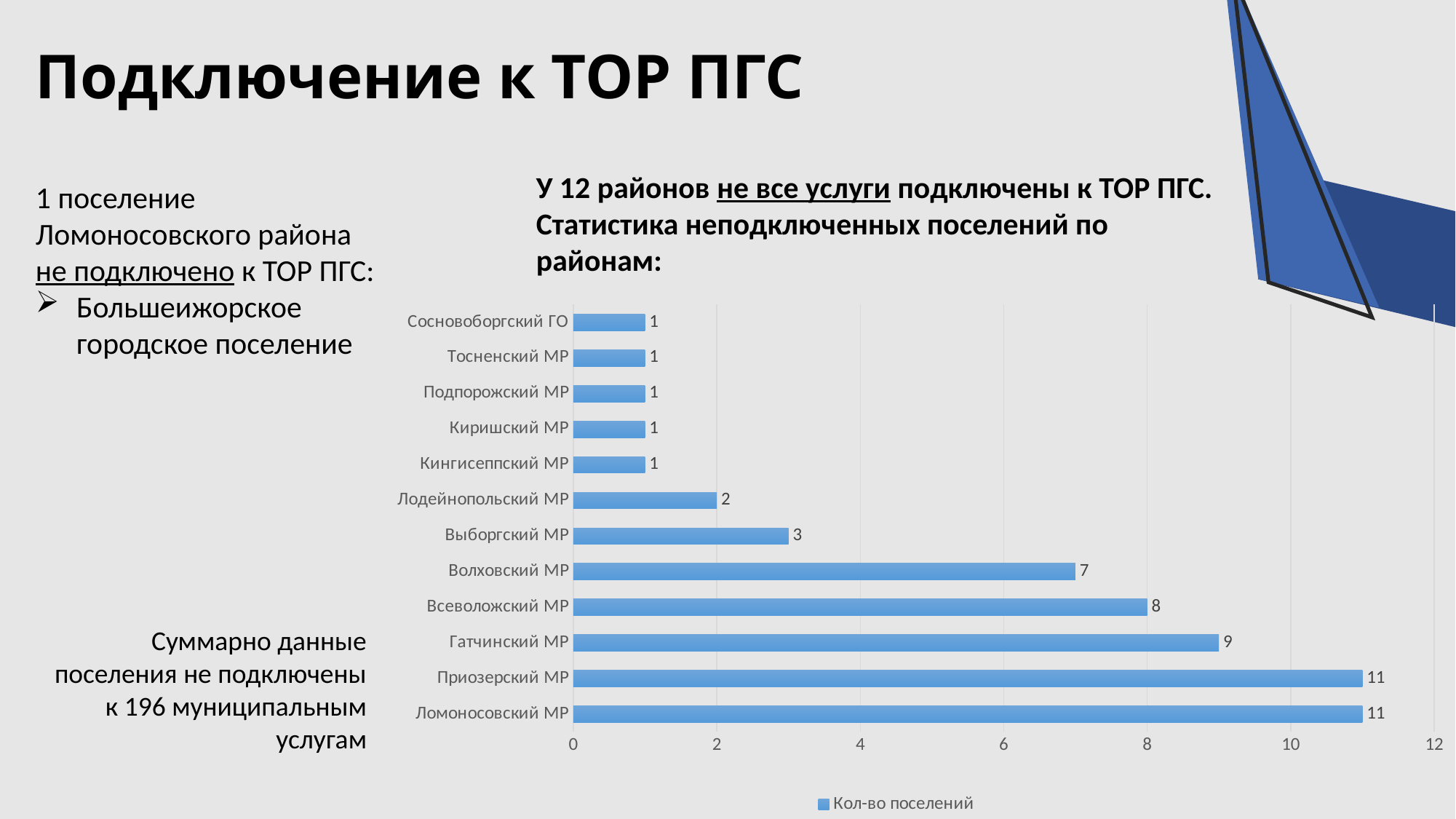
What is the value for Выборгский МР? 3 What is the difference between the values for Гатчинский МР and Выборгский МР? 6 How many series does the legend list? 1 What is the value for Гатчинский МР? 9 Is the value for Приозерский МР greater or less than 10? greater Which is larger, the value for Всеволожский МР or the value for Волховский МР? Всеволожский МР What is the value for Лодейнопольский МР? 2 What is the value for Приозерский МР? 11 How many categories are shown in the chart? 12 What is the value for Волховский МР? 7 What kind of chart is shown on the slide? bar chart What is the difference between the values for Ломоносовский МР and Всеволожский МР? 3